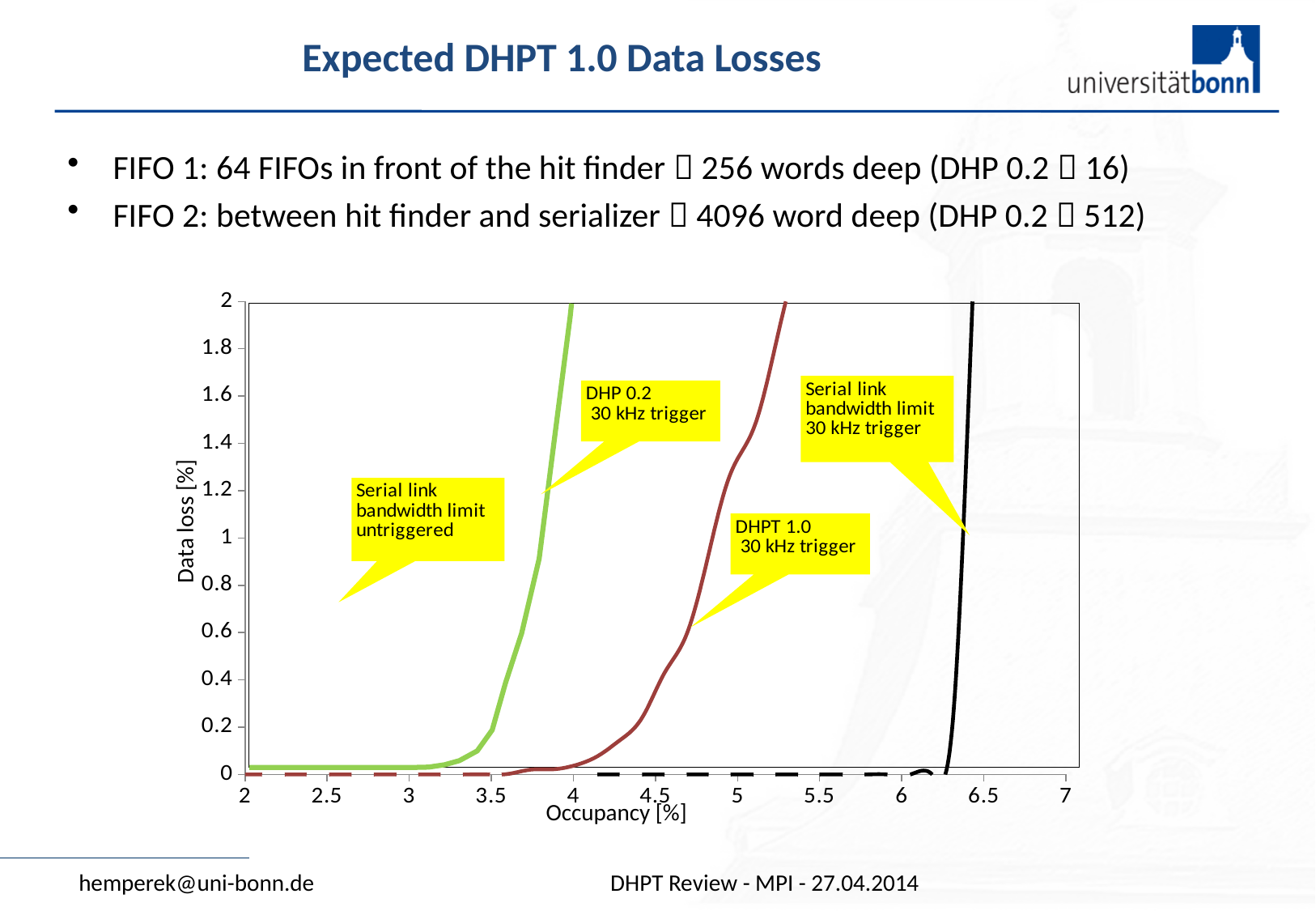
Is the data loss of the DHP 0.2 30 kHz trigger curve at an occupancy of 3.5% greater or less than 1%? less What is the label of the x axis of the chart? Occupancy [%] Does the data loss for the DHPT 1.0 30 kHz trigger curve rise or fall as occupancy increases? rise What is the maximum value shown on the y axis of the chart? 2 At an occupancy of 5%, which curve shows a higher data loss: DHPT 1.0 30 kHz trigger or Serial link bandwidth limit 30 kHz trigger? DHPT 1.0 30 kHz trigger Is the data loss of the DHPT 1.0 30 kHz trigger curve at an occupancy of 4.5% greater or less than 1%? less What kind of chart is shown on the slide? line chart Which curve reaches 2% data loss at the highest occupancy? Serial link bandwidth limit 30 kHz trigger At an occupancy of 4.5%, which curve shows a higher data loss: DHP 0.2 30 kHz trigger or DHPT 1.0 30 kHz trigger? DHP 0.2 30 kHz trigger Which curve reaches 2% data loss at the lowest occupancy? DHP 0.2 30 kHz trigger What is the label of the y axis of the chart? Data loss [%] Is the data loss of the DHPT 1.0 30 kHz trigger curve at an occupancy of 5% greater or less than 1%? greater